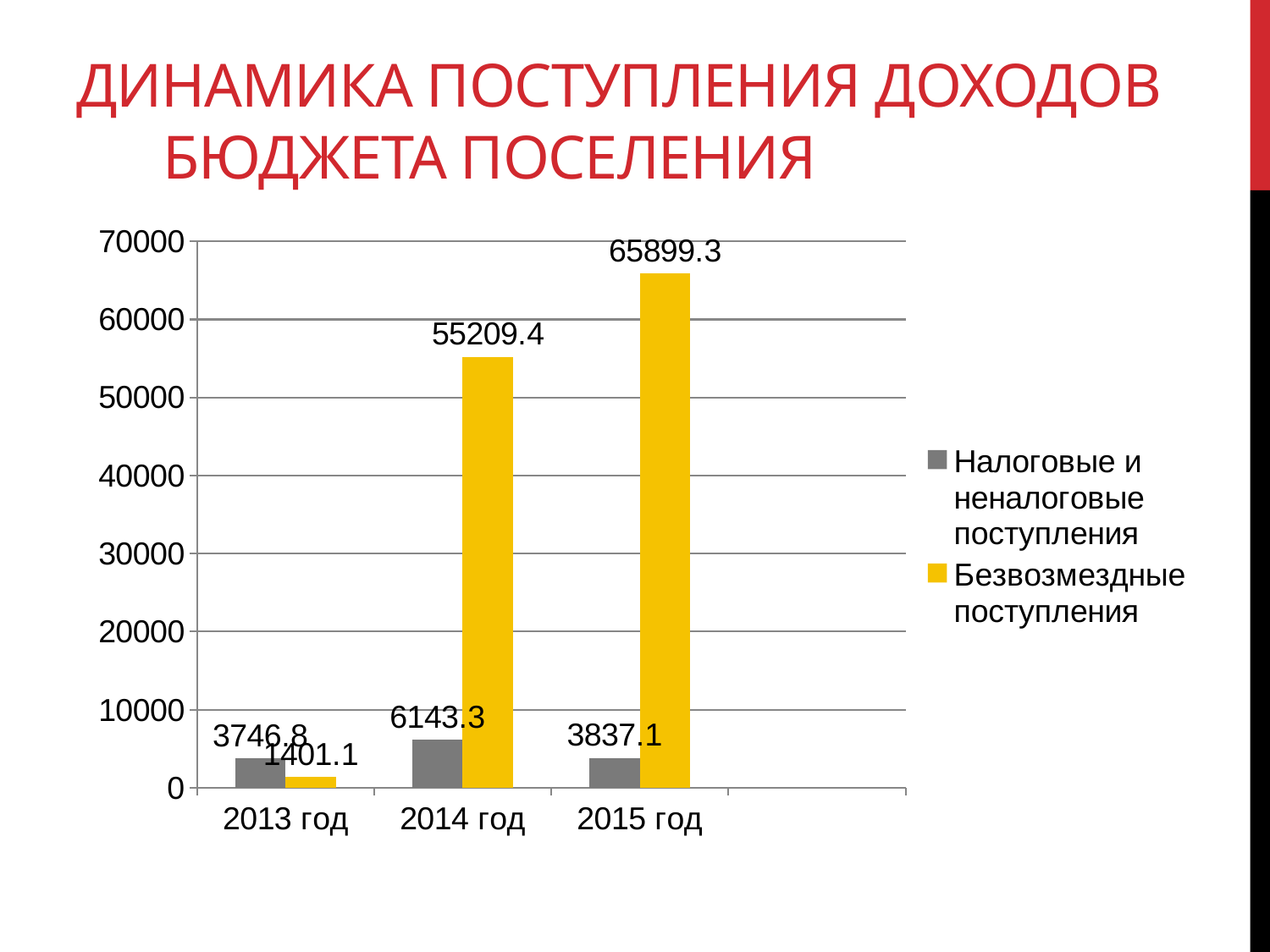
How many years are shown on the x axis? 3 Which colour represents Безвозмездные поступления in the chart? yellow What kind of chart is shown on the slide? bar chart What is the value of Безвозмездные поступления for 2013 год? 1401.1 Which is larger in 2013 год: Налоговые и неналоговые поступления or Безвозмездные поступления? Налоговые и неналоговые поступления In which year is Налоговые и неналоговые поступления lowest? 2013 год What is the difference between Безвозмездные поступления in 2015 год and 2014 год? 10689.9 What is the value of Налоговые и неналоговые поступления for 2014 год? 6143.3 What is the value of Безвозмездные поступления for 2015 год? 65899.3 Is the value of Безвозмездные поступления for 2014 год greater or less than 50000? greater How many series does the legend list? 2 In which year is Безвозмездные поступления highest? 2015 год